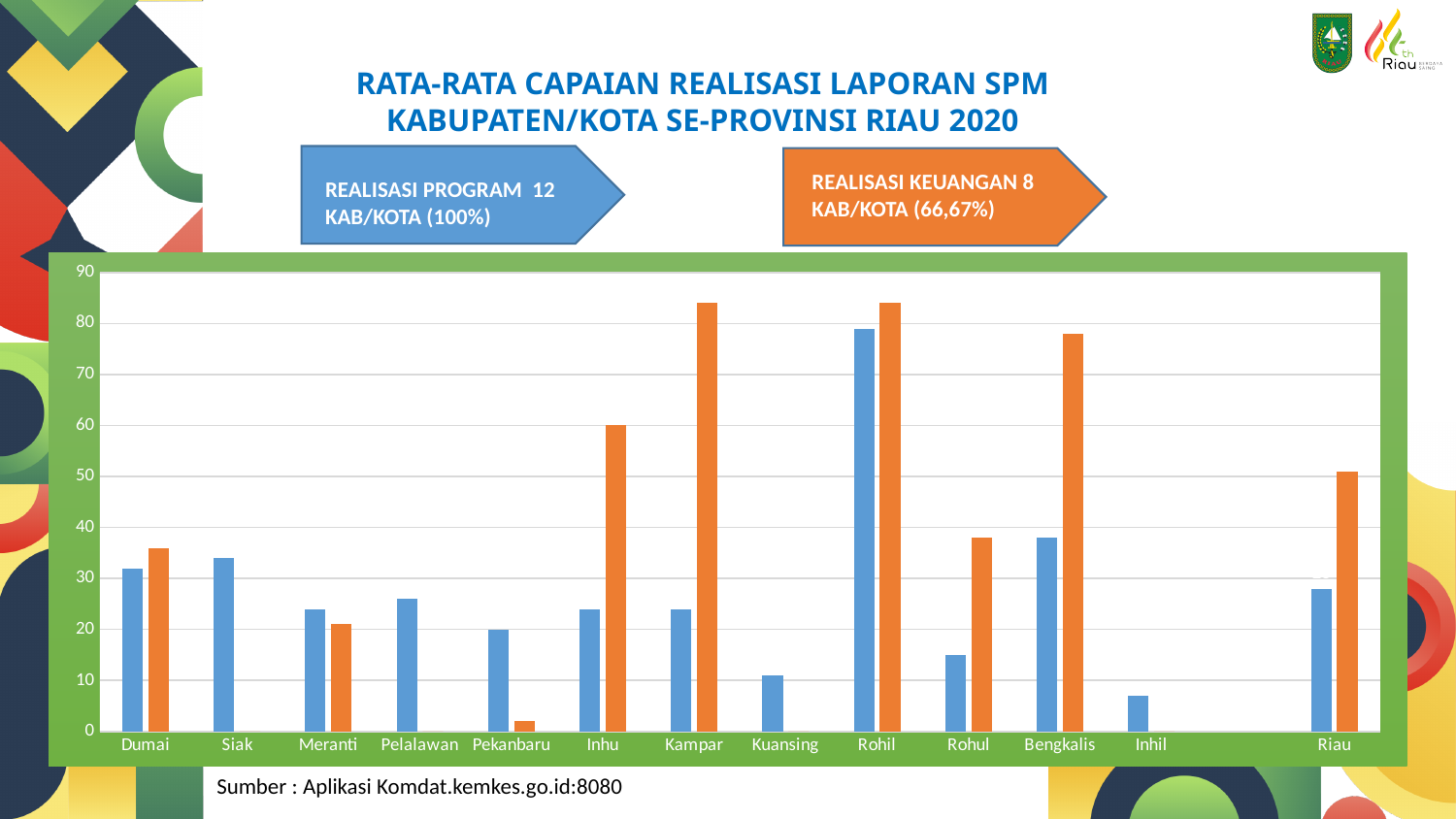
What is the highest value shown on the chart's vertical axis? 90 Which category has the shortest orange bar among those that have one? Pekanbaru Is the orange bar for Inhu greater or less than 50? greater What kind of chart is shown on the slide? bar chart How many categories are shown along the x axis of the chart? 13 For Bengkalis, which bar is taller, the blue one or the orange one? orange Which category has the shortest blue bar? Inhil Is the blue bar for Rohil greater or less than 70? greater Is the orange bar for Riau greater or less than 40? greater Which category has the tallest blue bar? Rohil Which blue bar is taller, Rohil or Dumai? Rohil